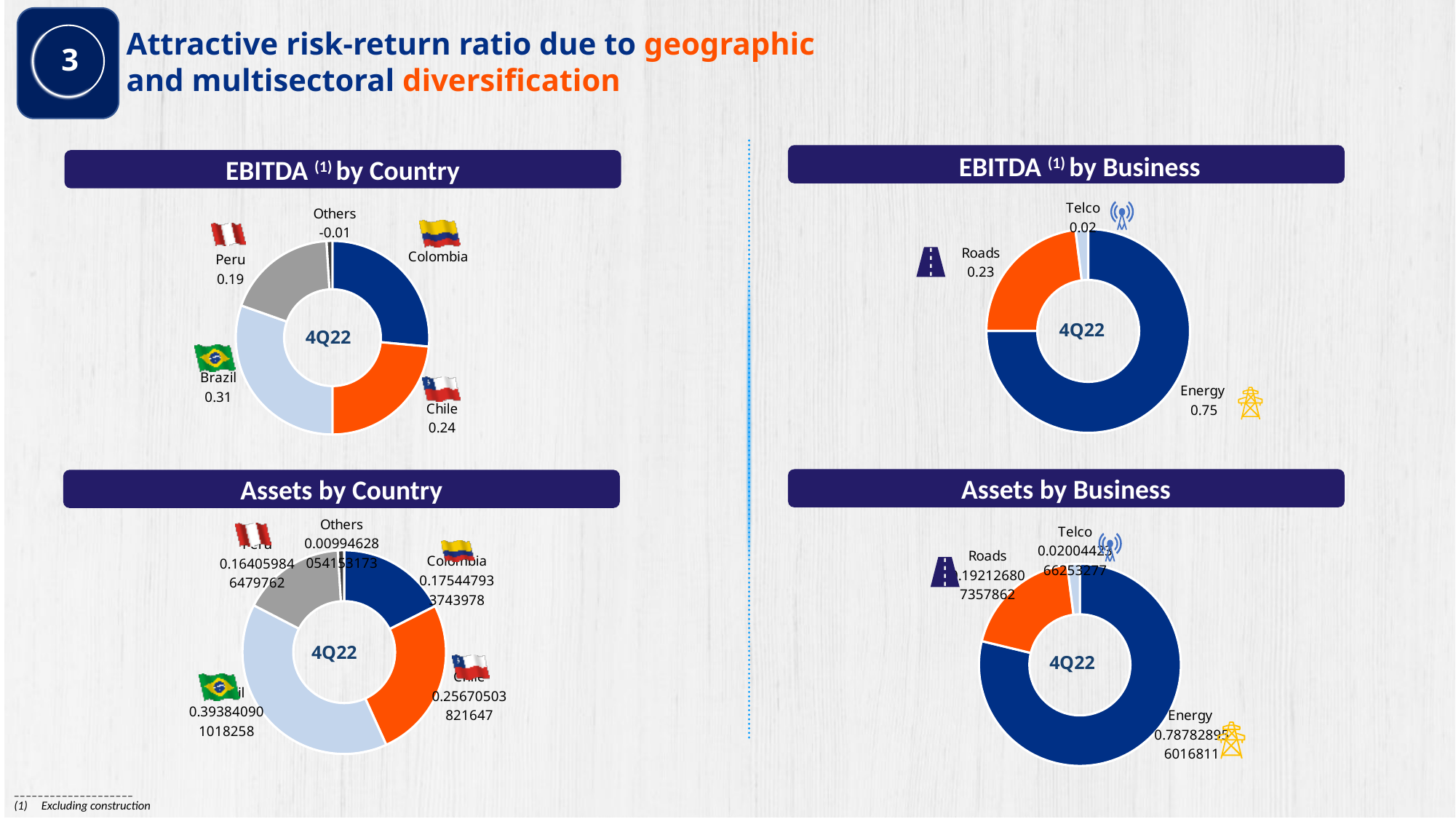
In the EBITDA by Business chart, which business has the largest share? Energy In the Assets by Business chart, which business has the smallest share? Telco In the EBITDA by Country chart, what is the value for Others? -0.01 In the Assets by Country chart, which country has the largest share? Brazil In the EBITDA by Business chart, what is the value for Energy? 0.75 In the EBITDA by Country chart, what is the value for Chile? 0.24 In the EBITDA by Business chart, what is the value for Roads? 0.23 In the EBITDA by Country chart, what is the value for Peru? 0.19 In the EBITDA by Business chart, what is the difference between the Energy and Roads values? 0.52 In the EBITDA by Country chart, which is larger, Brazil or Chile? Brazil In the EBITDA by Business chart, what is the value for Telco? 0.02 In the EBITDA by Country chart, what is the value for Brazil? 0.31